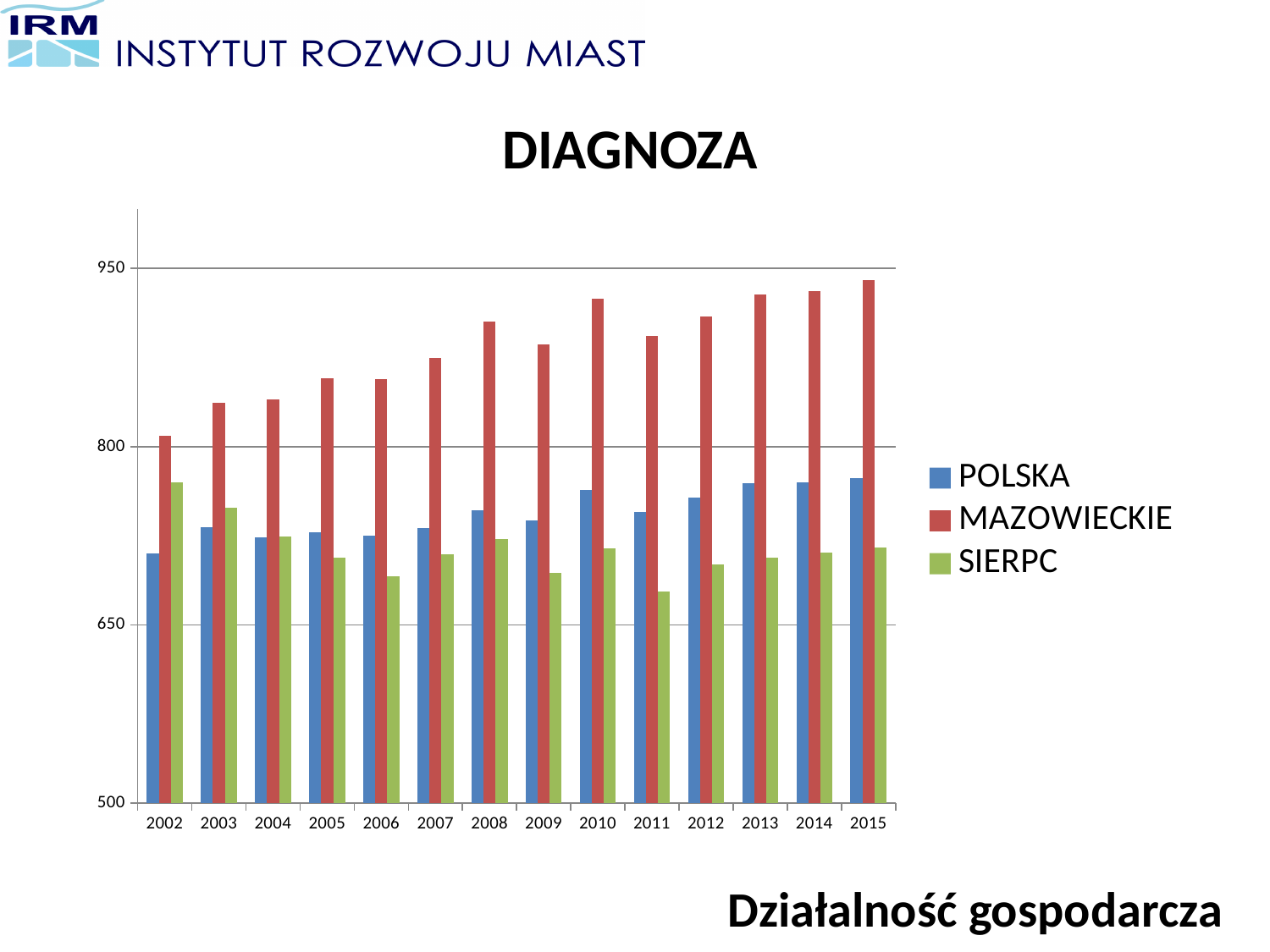
Is the value for MAZOWIECKIE in 2015 greater or less than 800? greater Is the value for SIERPC in 2011 greater or less than 650? greater In 2002, which is larger: the value for POLSKA or the value for SIERPC? SIERPC What kind of chart is shown on the slide? bar chart In 2015, which is larger: the value for POLSKA or the value for SIERPC? POLSKA In which year is the SIERPC value lowest? 2011 How many series does the chart's legend list? 3 Is the value for POLSKA in 2002 greater or less than 800? less How many years are shown on the x axis of the chart? 14 Which series has the highest value in 2015? MAZOWIECKIE Do the MAZOWIECKIE values generally rise or fall from 2002 to 2015? rise